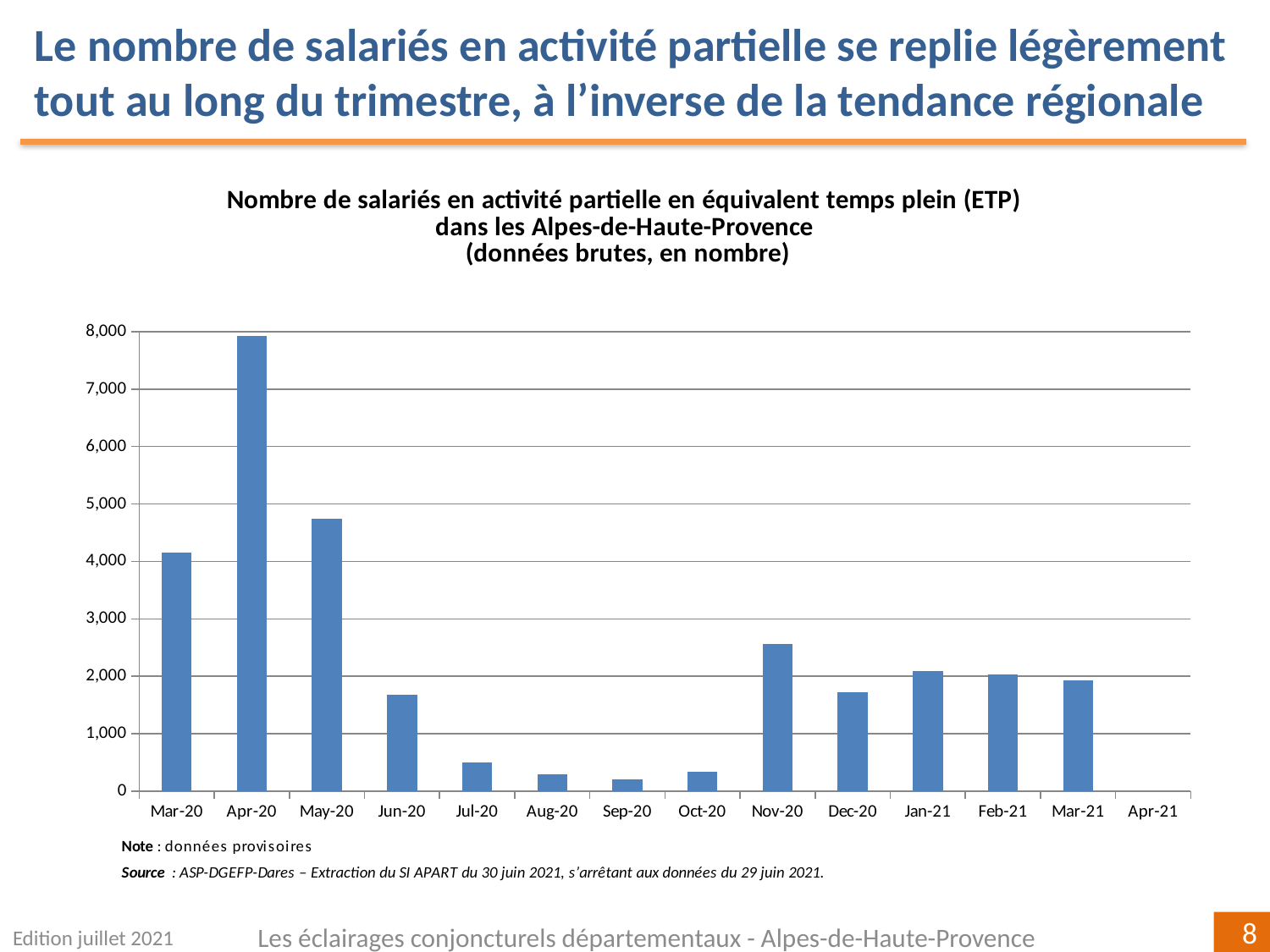
Which is larger, the value for Nov-20 or the value for Dec-20? Nov-20 How many month labels are shown on the x axis? 14 What kind of chart is shown on the slide? Bar chart Is the value for Jul-20 greater or less than 1,000? less Which month has the highest number of salariés en activité partielle (ETP)? Apr-20 Is the value for Apr-20 greater or less than 7,000? greater Which is larger, the value for Mar-20 or the value for May-20? May-20 Is the value for Nov-20 greater or less than 2,000? greater Do the values rise or fall from Apr-20 to Sep-20? Fall Among the months with a visible bar, which month has the lowest value? Sep-20